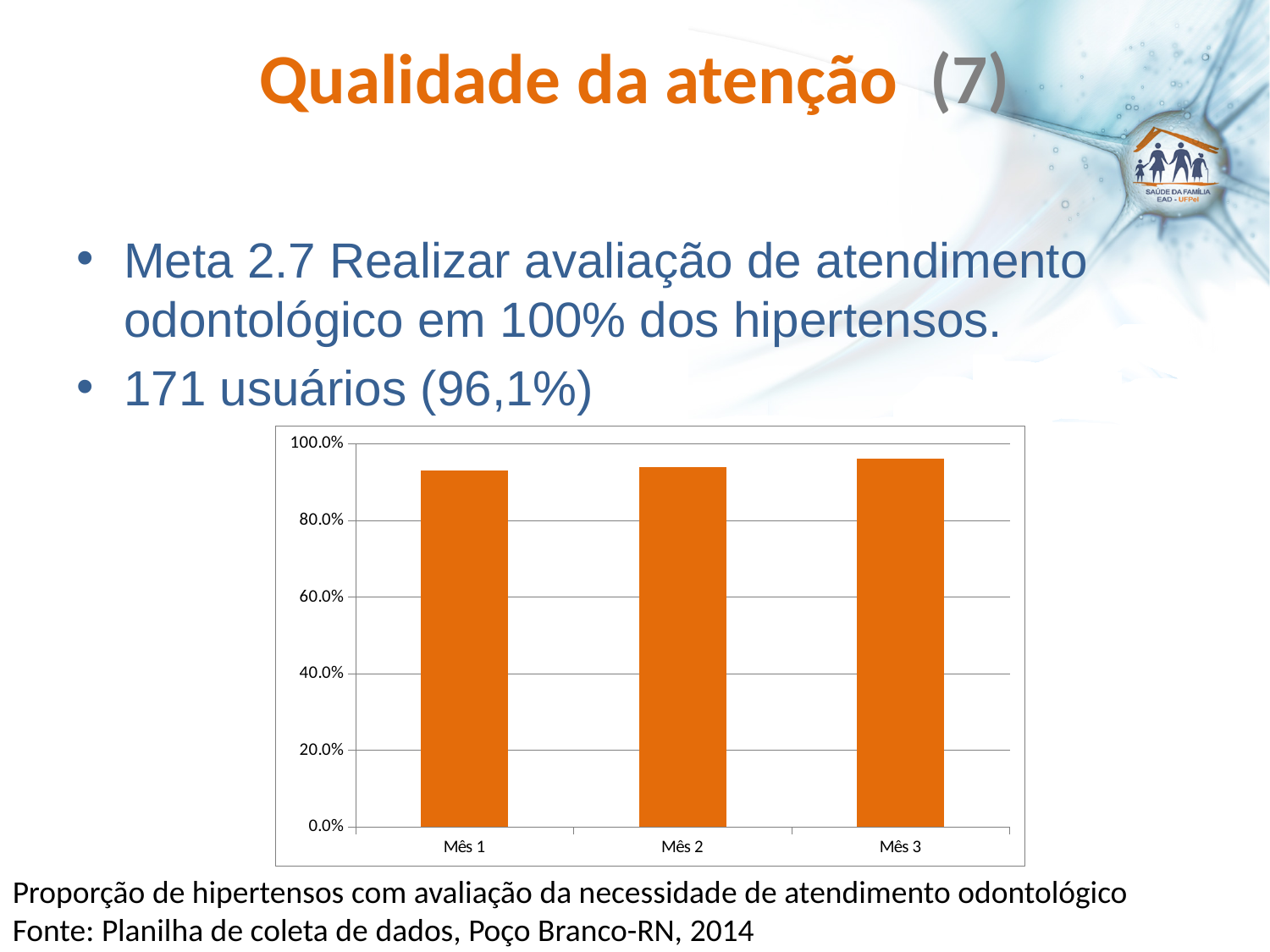
Is the value for Mês 1 greater or less than 80.0%? greater What kind of chart is shown on the slide? bar chart What colour are the bars in the chart? orange Which is larger, the value for Mês 1 or the value for Mês 3? Mês 3 Which month has the highest bar on the chart? Mês 3 Do the values rise or fall from Mês 1 to Mês 3? rise What is the label of the first category on the x axis? Mês 1 Is the value for Mês 3 greater or less than 100.0%? less How many categories (months) are plotted on the chart? 3 Is the value for Mês 2 greater or less than 60.0%? greater